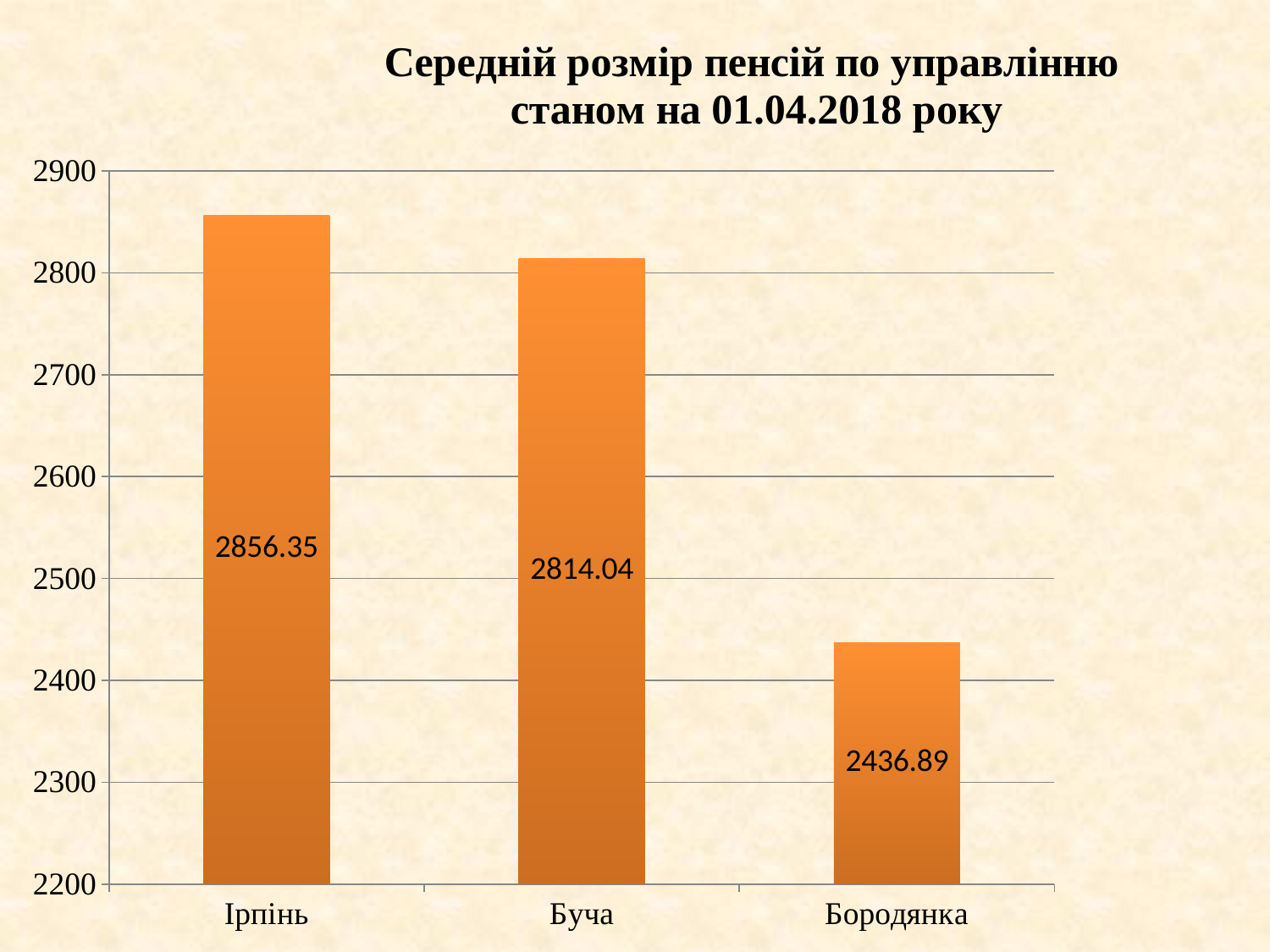
Is the value for Бородянка greater or less than 2500? less How many categories are shown on the x axis? 3 Which category has the lowest value? Бородянка What is the difference between the values for Буча and Бородянка? 377.15 What is the difference between the values for Ірпінь and Буча? 42.31 Which category has the highest value? Ірпінь Which is larger, the value for Буча or the value for Бородянка? Буча What is the value for Ірпінь? 2856.35 What is the value for Бородянка? 2436.89 What kind of chart is this? bar chart What is the value for Буча? 2814.04 Do the values rise or fall from left to right along the x axis? fall